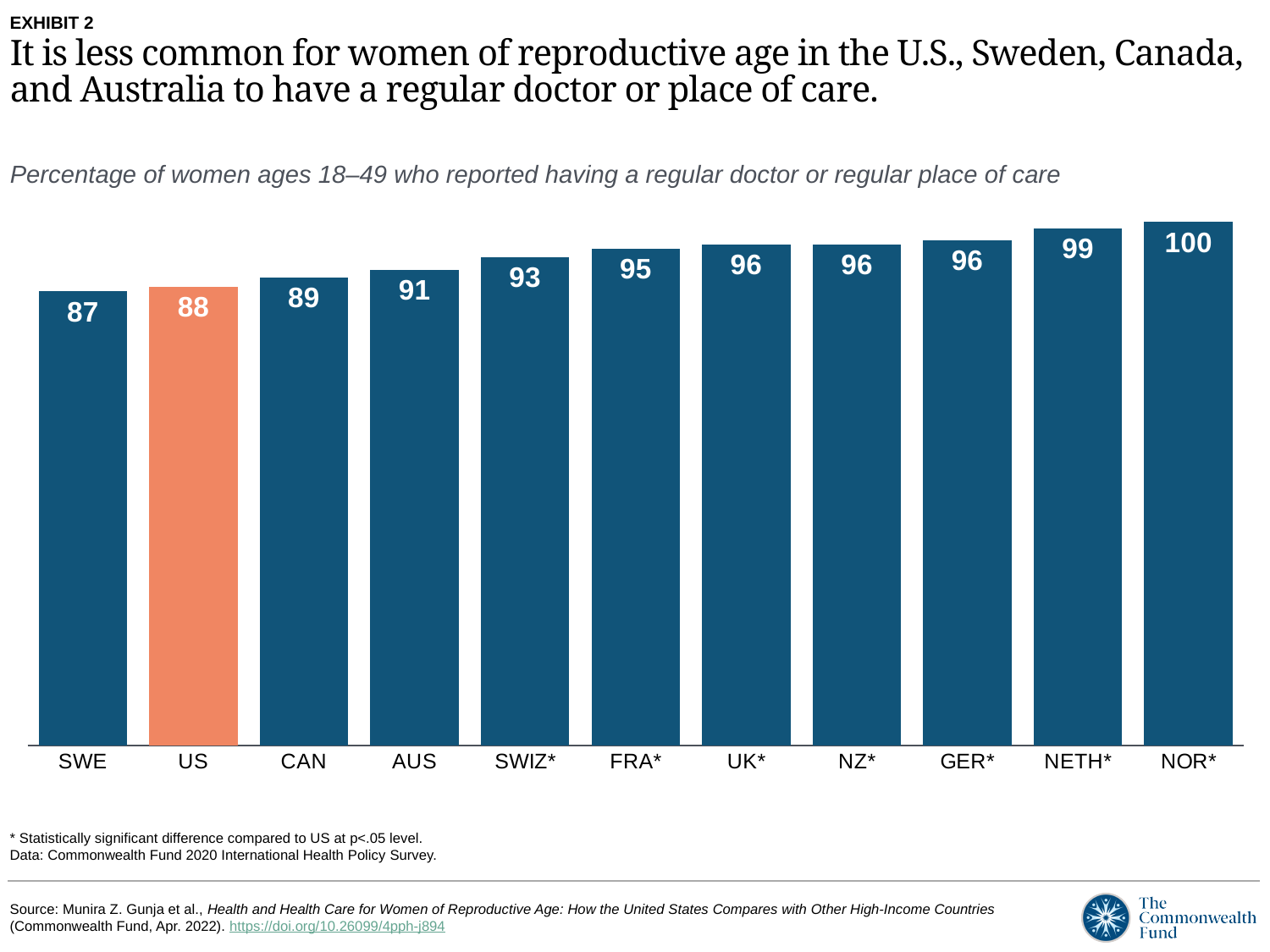
What is the difference between the values for AUS and US? 3 How many countries are shown in the chart? 11 Which is larger, the value for CAN or the value for FRA*? FRA* What is the value for SWIZ*? 93 Which country has the highest value? NOR* Which country has the lowest value? SWE What is the value for NETH*? 99 What is the value for the US? 88 Which bar is shown in a different colour (orange) from the others? US What kind of chart is this? bar chart Do the values rise or fall from left to right across the x axis? rise What is the difference between the values for NOR* and SWE? 13